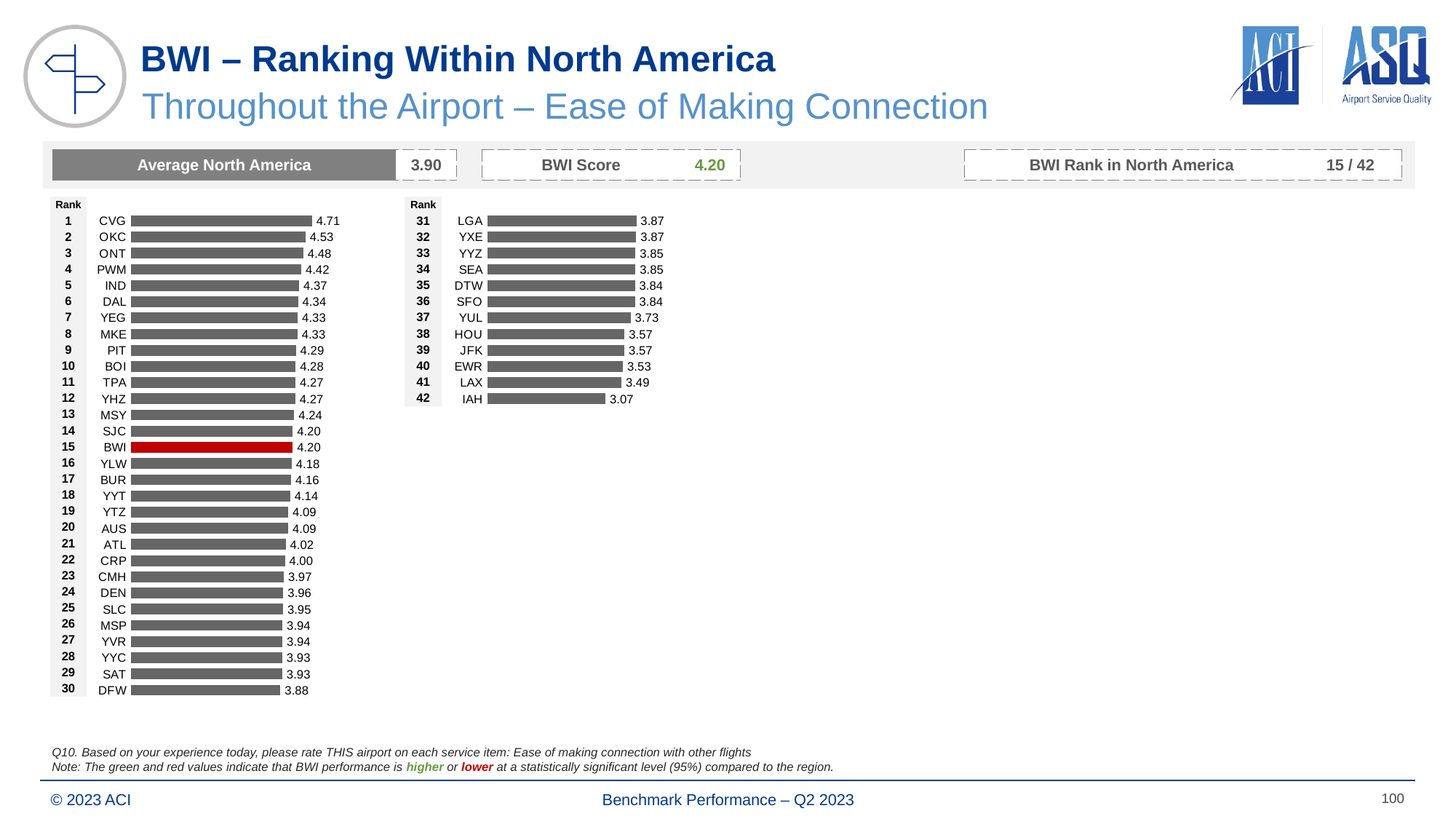
How many airports are listed in the left chart (ranks 1–30)? 30 What is the score for BWI in the ranking chart? 4.20 What is the score for CVG in the left chart? 4.71 Which airport has the highest score in the left chart? CVG Which airport has the lowest score in the right chart? IAH How many airports are listed in the right chart (ranks 31–42)? 12 What type of chart is used to show the airport rankings? Bar chart Which bar in the left chart is highlighted in red? BWI What is the difference between the scores of CVG and BWI in the left chart? 0.51 In the right chart (ranks 31–42), what is the score for IAH? 3.07 Do the scores rise or fall as you go down the ranking in the left chart? Fall Which has a higher score in the left chart, OKC or ONT? OKC